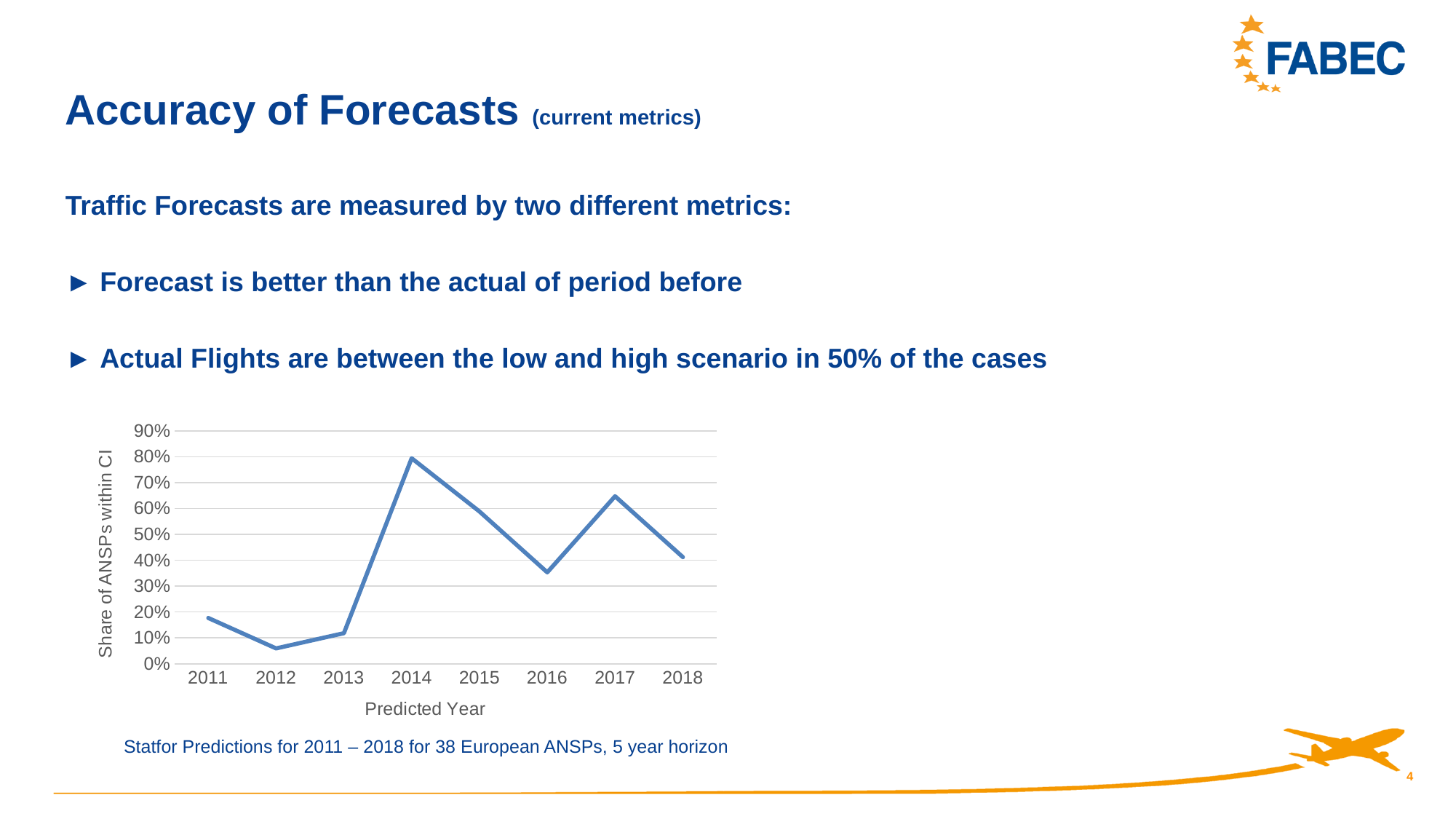
Does the share of ANSPs within CI rise or fall from 2014 to 2016? fall What is the label of the y axis? Share of ANSPs within CI What is the label of the x axis? Predicted Year Which predicted year has the lowest share of ANSPs within CI? 2012 How many predicted years are plotted on the x axis? 8 Is the share of ANSPs within CI for 2012 greater or less than 10%? less Which year has a larger share of ANSPs within CI, 2015 or 2018? 2015 Is the share of ANSPs within CI for 2014 greater or less than 70%? greater Is the share of ANSPs within CI for 2017 greater or less than 60%? greater Which predicted year has the highest share of ANSPs within CI? 2014 What kind of chart is shown on the slide? line chart